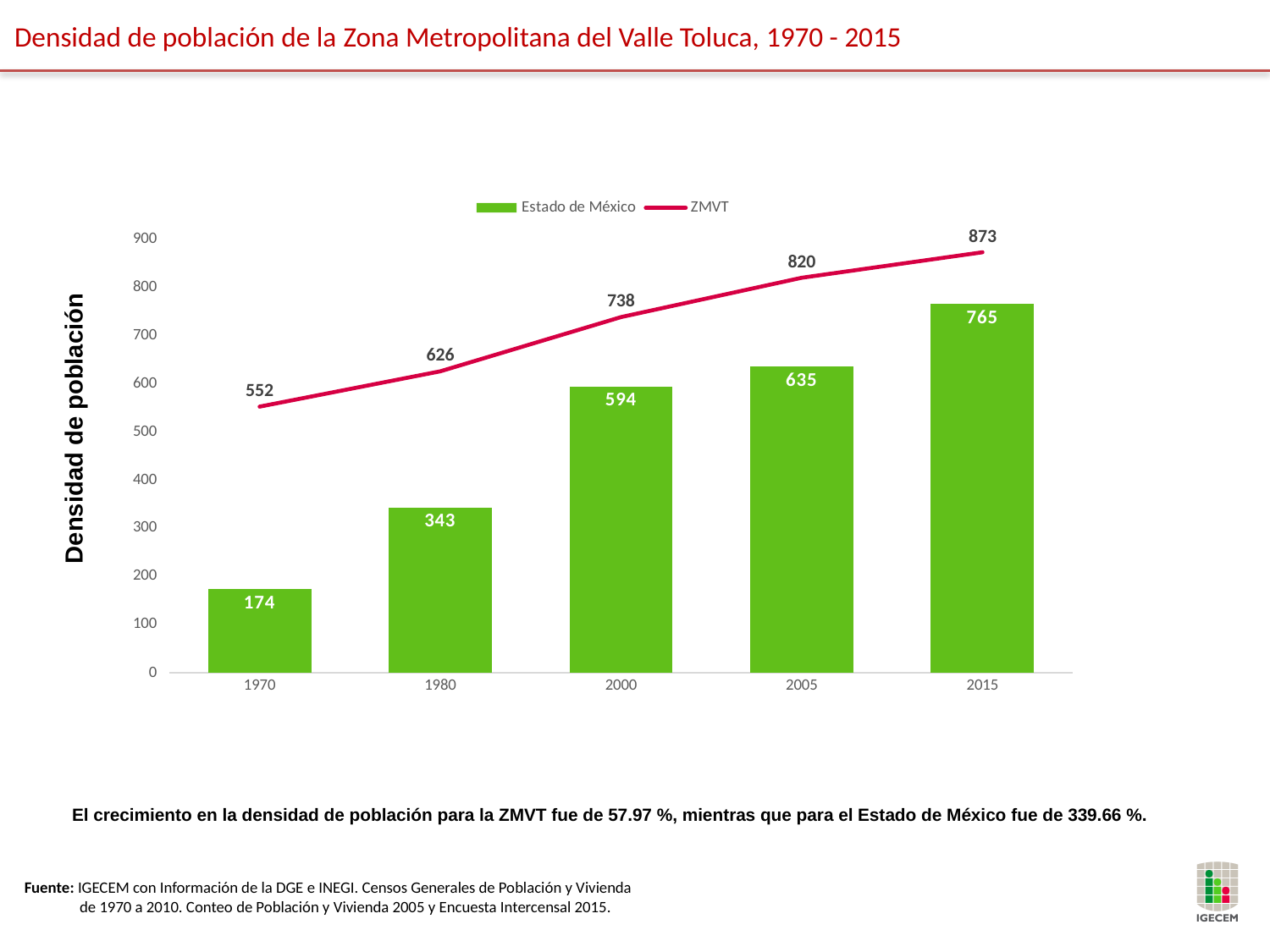
What is the population density value for Estado de México in 1970? 174 Does the Estado de México population density rise or fall from 1970 to 2015? rise In which year is the Estado de México population density lowest? 1970 How many years are shown on the x axis? 5 In which year is the ZMVT population density highest? 2015 What is the population density value for ZMVT in 2005? 820 How many series does the legend list? 2 What is the population density value for Estado de México in 2000? 594 What is the label of the vertical axis? Densidad de población What is the difference between the ZMVT value and the Estado de México value in 2015? 108 What is the difference between the Estado de México values for 1980 and 1970? 169 Which is larger in 1980, the ZMVT value or the Estado de México value? ZMVT